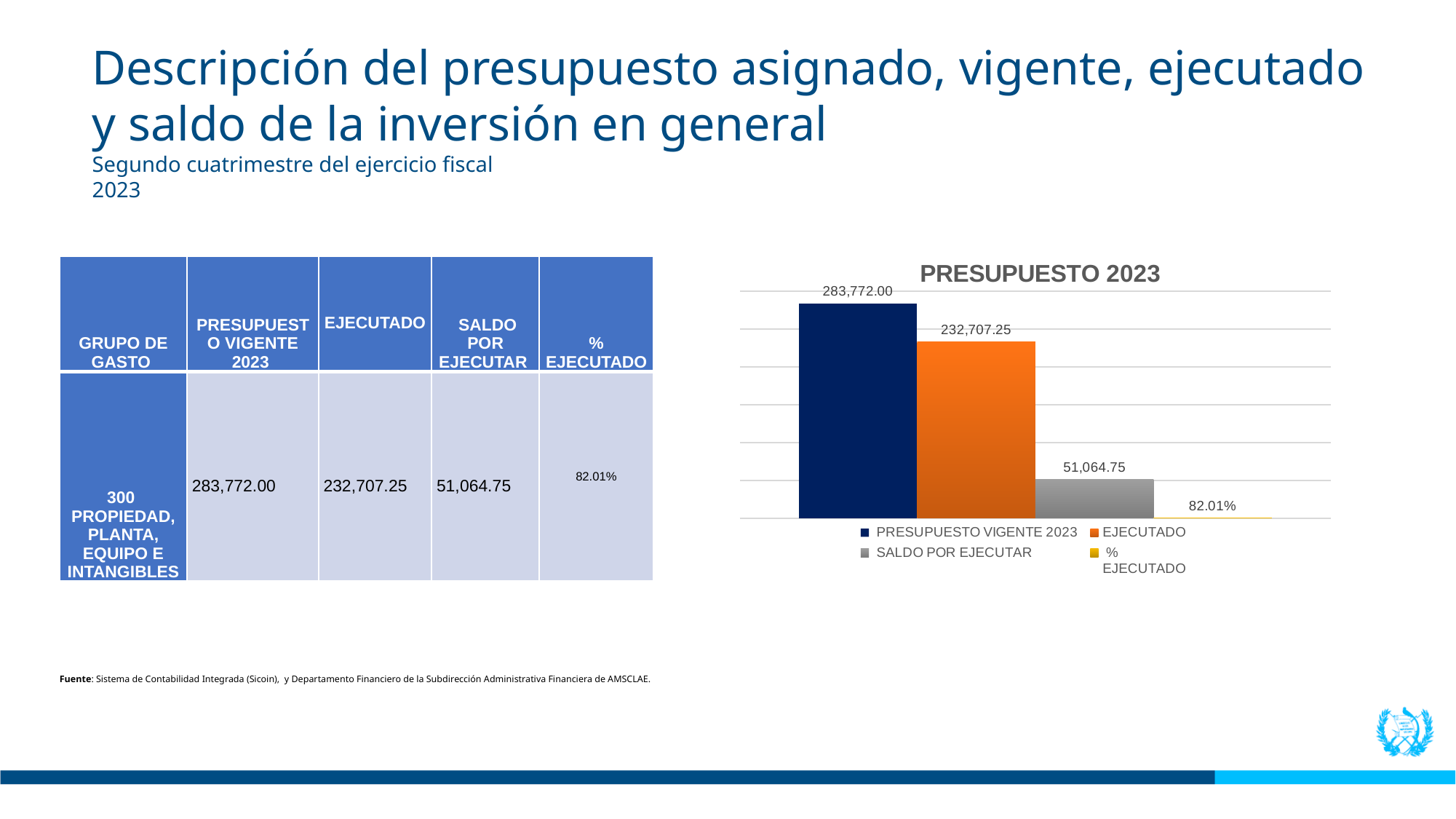
What type of chart is shown on the slide? bar chart What value is shown for the % EJECUTADO series? 82.01% Which is larger, EJECUTADO or SALDO POR EJECUTAR? EJECUTADO What colour is the EJECUTADO bar? orange What is the value of the SALDO POR EJECUTAR bar? 51,064.75 How many series does the chart legend list? 4 Which of the three amount bars is the lowest? SALDO POR EJECUTAR What is the value of the PRESUPUESTO VIGENTE 2023 bar? 283,772.00 Which series has the highest value in the chart? PRESUPUESTO VIGENTE 2023 What is the value of the EJECUTADO bar? 232,707.25 What is the title of the chart? PRESUPUESTO 2023 What is the difference between PRESUPUESTO VIGENTE 2023 and EJECUTADO? 51,064.75